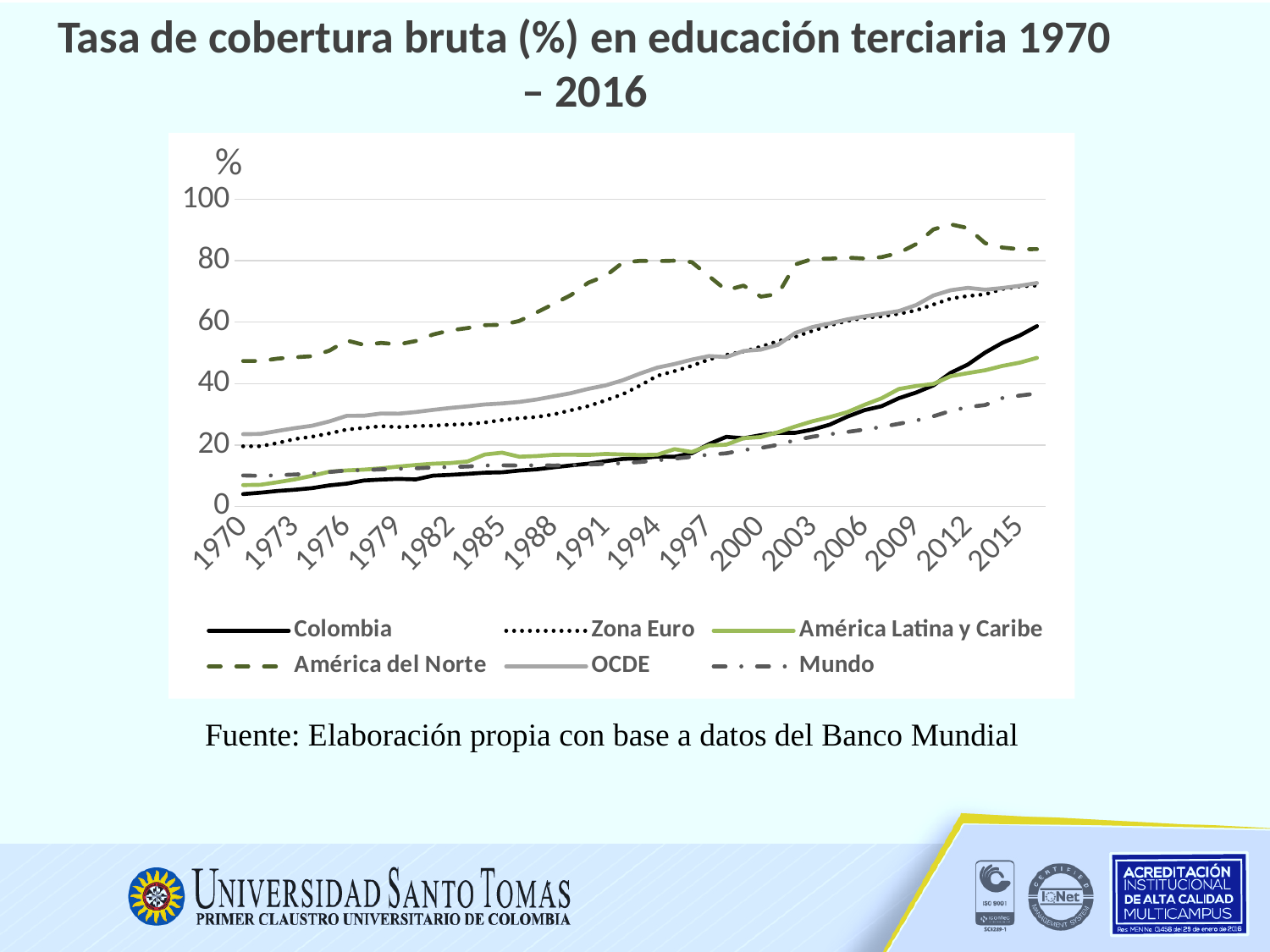
What is the title of the chart on the slide? Tasa de cobertura bruta (%) en educación terciaria 1970 – 2016 Which series has the highest value in 2016? América del Norte Which series has the lowest value in 1970? Colombia Is the value for América del Norte in 2012 greater or less than 80? greater Does the value for Colombia rise or fall from 1970 to 2016? rise In 1970, which is larger: the value for Mundo or the value for Colombia? Mundo In 2016, which is larger: the value for Colombia or the value for América Latina y Caribe? Colombia Is the value for Colombia in 1970 greater or less than 20? less What kind of chart is shown on the slide? line chart Is the value for Colombia in 2016 greater or less than 40? greater How many series does the legend list? 6